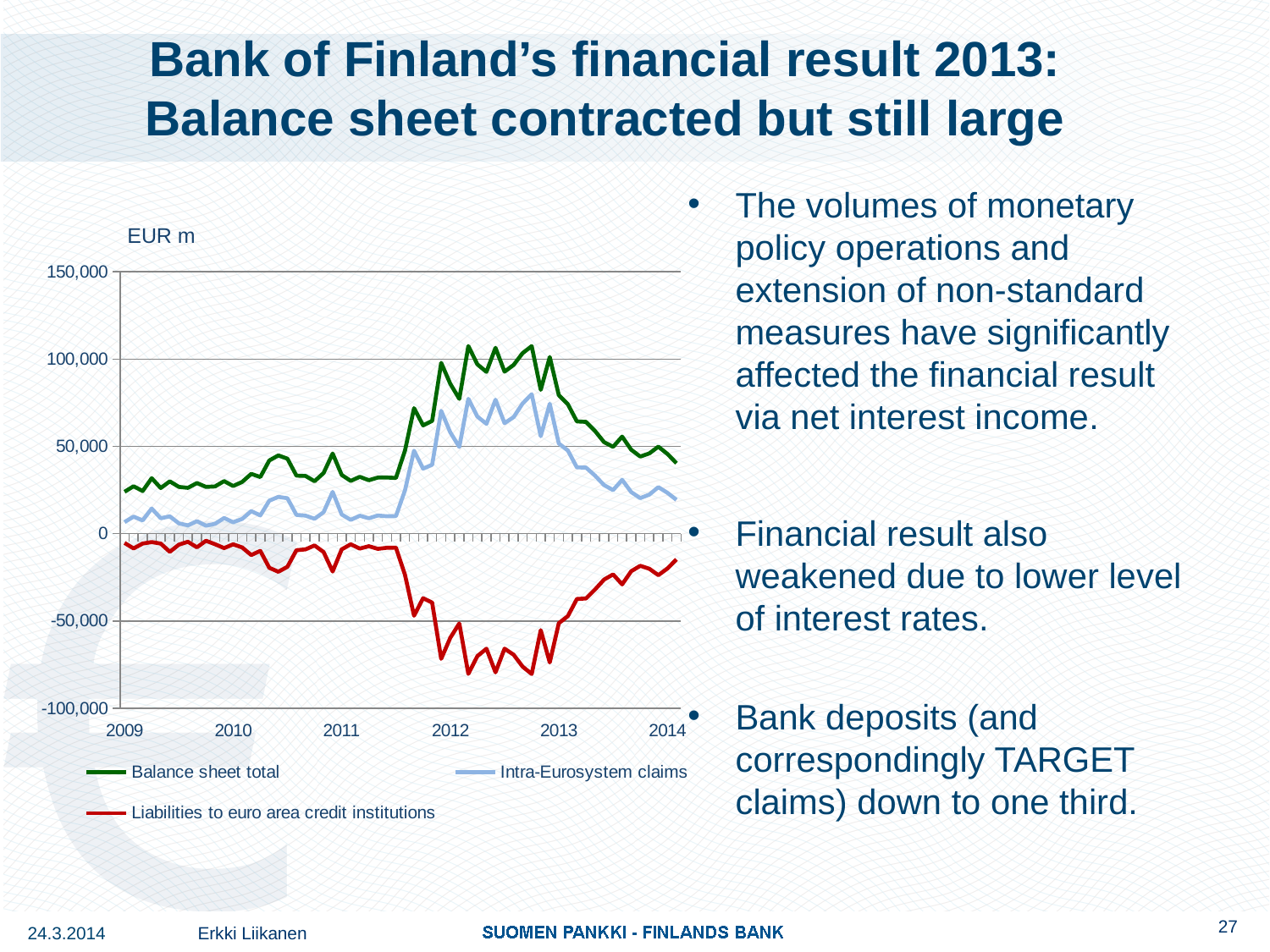
Is the lowest value of Liabilities to euro area credit institutions during 2012 greater or less than -50,000? less Is the peak value of Balance sheet total during 2012 greater or less than 100,000? greater Does the Balance sheet total rise or fall from the start of 2013 to the start of 2014? fall What kind of chart is shown on the slide? line chart What unit is shown above the y axis of the chart? EUR m How many series does the chart legend list? 3 Which series is drawn in red on the chart? Liabilities to euro area credit institutions Which series has negative values throughout the chart? Liabilities to euro area credit institutions Which series has the highest values throughout the chart? Balance sheet total Is the value of Balance sheet total at the start of 2009 greater or less than 50,000? less How many year labels are shown on the x axis of the chart? 6